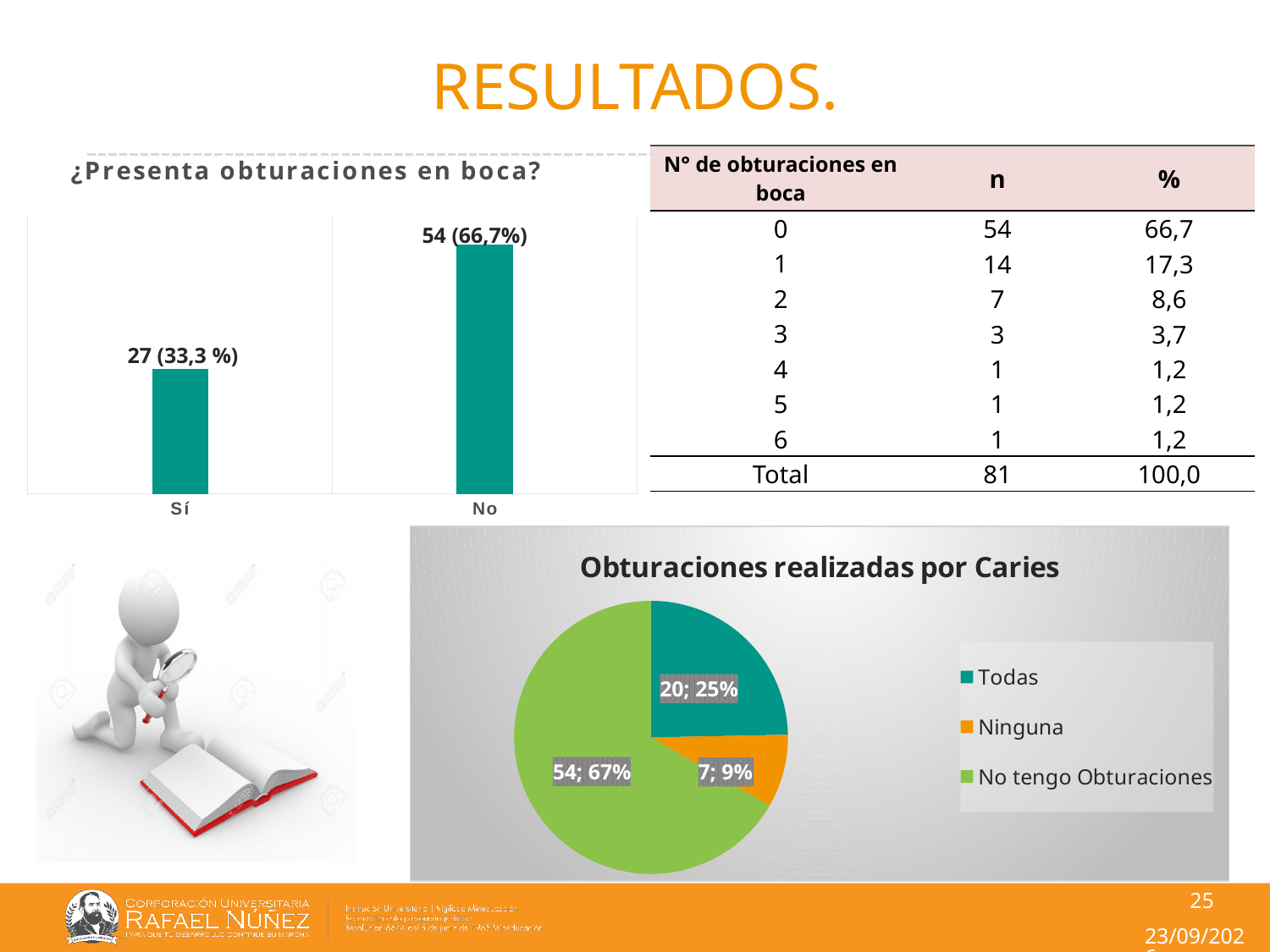
In the bar chart '¿Presenta obturaciones en boca?', how many categories are shown? 2 In the pie chart 'Obturaciones realizadas por Caries', what colour is the 'Ninguna' slice? orange What kind of chart is '¿Presenta obturaciones en boca?'? bar chart In the bar chart '¿Presenta obturaciones en boca?', which category has the higher value? No In the pie chart 'Obturaciones realizadas por Caries', which slice is the smallest? Ninguna In the pie chart 'Obturaciones realizadas por Caries', how many entries does the legend list? 3 In the pie chart 'Obturaciones realizadas por Caries', what share does 'No tengo Obturaciones' have? 67% In the bar chart '¿Presenta obturaciones en boca?', what is the data label for 'Sí'? 27 (33,3 %) In the bar chart '¿Presenta obturaciones en boca?', what is the data label for 'No'? 54 (66,7%) What kind of chart is 'Obturaciones realizadas por Caries'? pie chart In the bar chart '¿Presenta obturaciones en boca?', what is the difference in count between 'No' and 'Sí'? 27 In the pie chart 'Obturaciones realizadas por Caries', what is the data label for 'Todas'? 20; 25%